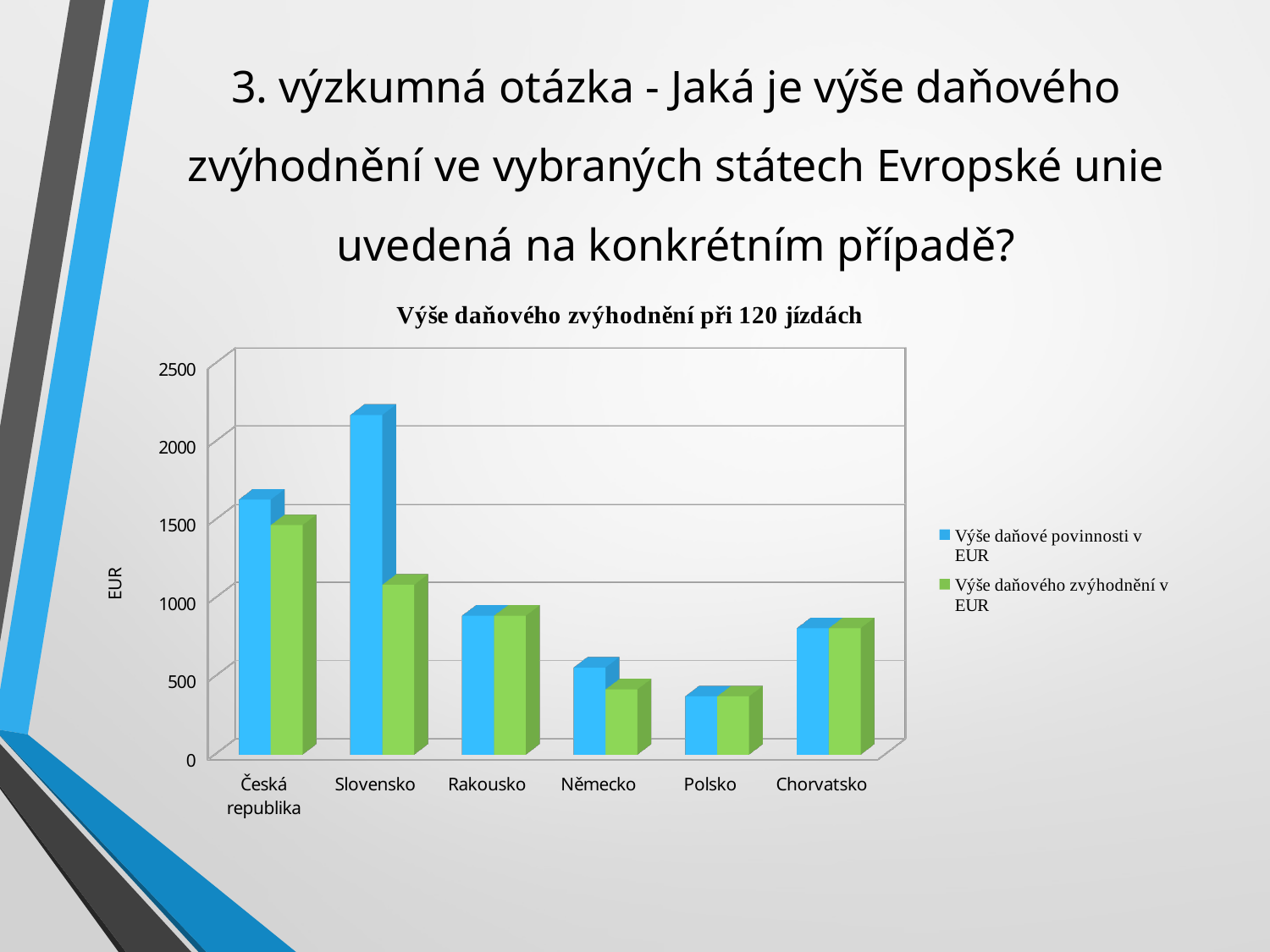
How many series does the legend list? 2 What is the title of the chart? Výše daňového zvýhodnění při 120 jízdách What is the label of the vertical axis? EUR Which country has the lowest value for Výše daňové povinnosti v EUR? Polsko Which country has the highest value for Výše daňové povinnosti v EUR? Slovensko What type of chart is shown on the slide? bar chart Is the value of Výše daňové povinnosti v EUR for Polsko greater or less than 500? less Is the value of Výše daňového zvýhodnění v EUR for Slovensko greater or less than 1500? less How many countries are shown on the x axis? 6 For Slovensko, which is larger: Výše daňové povinnosti v EUR or Výše daňového zvýhodnění v EUR? Výše daňové povinnosti v EUR Is the value of Výše daňové povinnosti v EUR for Slovensko greater or less than 2000? greater Which country has the highest value for Výše daňového zvýhodnění v EUR? Česká republika